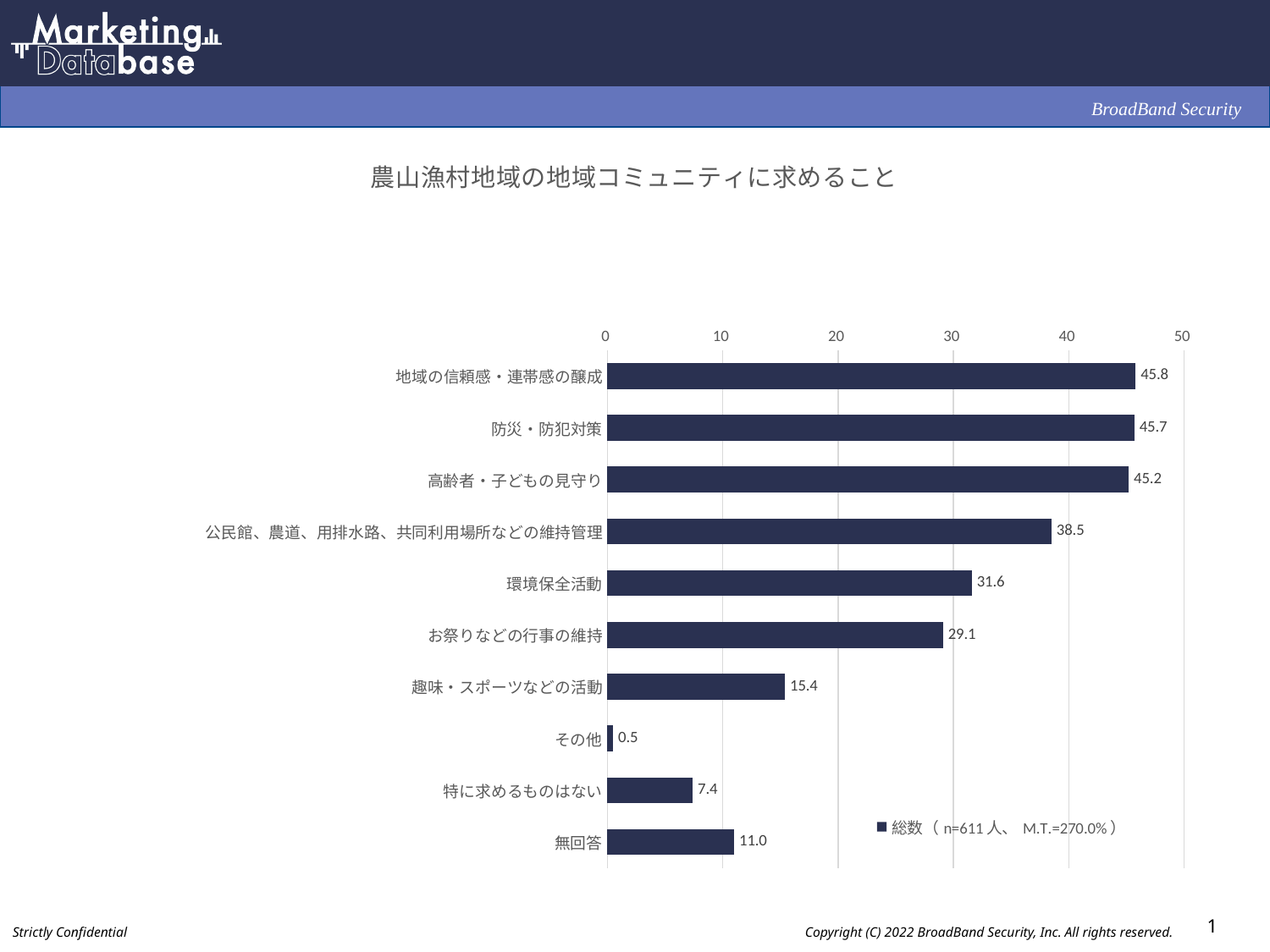
Which category has the highest value? 地域の信頼感・連帯感の醸成 How many categories are shown in the chart? 10 Which category has the lowest value? その他 What is the title of the chart? 農山漁村地域の地域コミュニティに求めること Which is larger, the value for 特に求めるものはない or the value for 無回答? 無回答 What kind of chart is shown on the slide? bar chart Is the value for 趣味・スポーツなどの活動 greater or less than 20? less How many series does the legend list? 1 What is the value for 地域の信頼感・連帯感の醸成? 45.8 What is the difference between the values for 公民館、農道、用排水路、共同利用場所などの維持管理 and お祭りなどの行事の維持? 9.4 What is the value for 無回答? 11.0 What is the value for 環境保全活動? 31.6